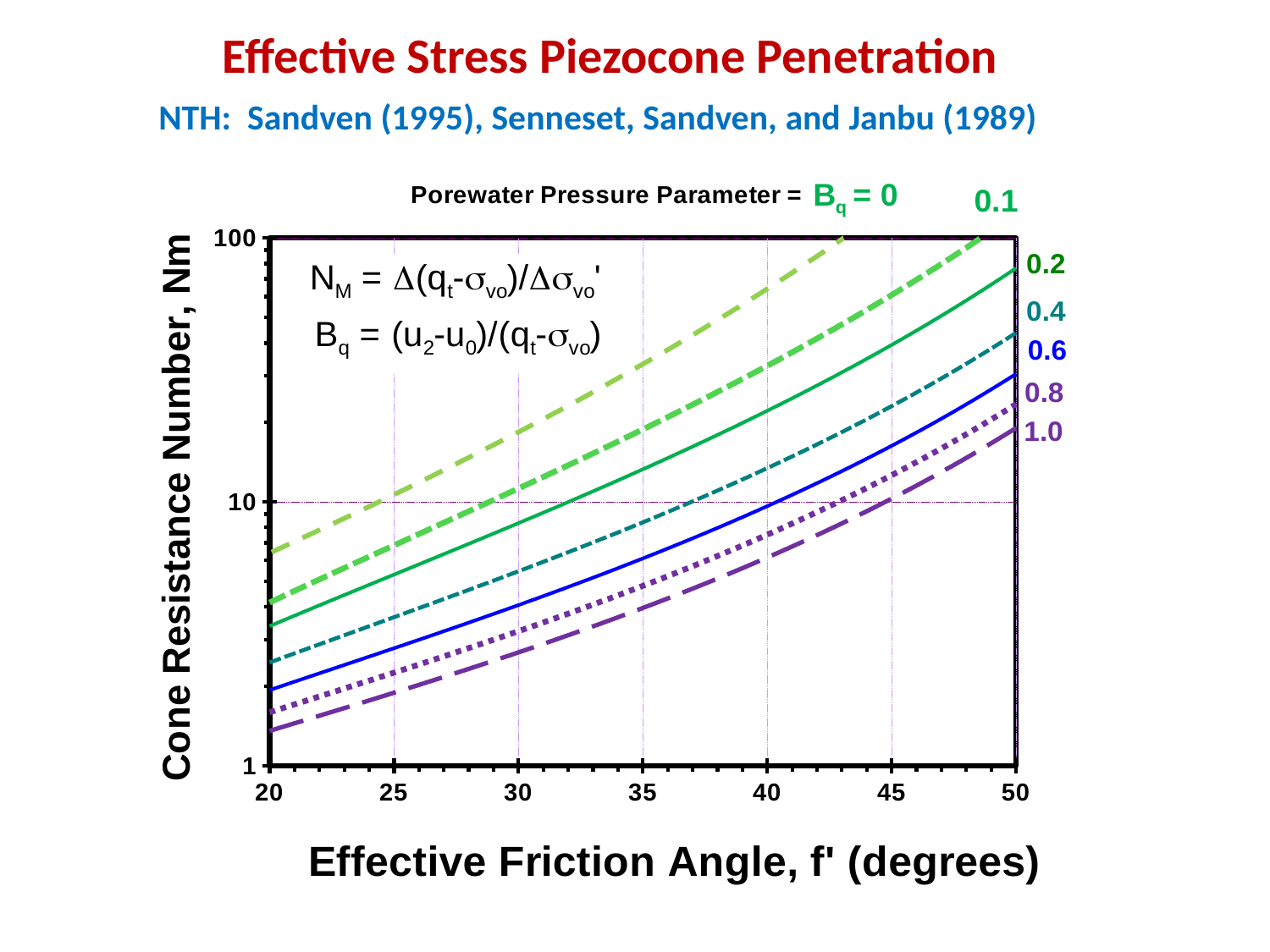
At a friction angle of 35 degrees, which curve has the larger cone resistance number, Bq = 0.2 or Bq = 0.8? Bq = 0.2 Which Bq curve has the lowest cone resistance number at any given friction angle? Bq = 1.0 What kind of chart is shown on the slide? line chart Which Bq curve has the highest cone resistance number at any given friction angle? Bq = 0 Is the cone resistance number for Bq = 1.0 at a friction angle of 40 degrees greater or less than 10? less Is the cone resistance number for Bq = 0.8 at a friction angle of 50 degrees greater or less than 10? greater What is the label of the y axis? Cone Resistance Number, Nm Is the cone resistance number for Bq = 0 at a friction angle of 30 degrees greater or less than 10? greater What is the label of the x axis? Effective Friction Angle, f' (degrees) Do the curves rise or fall as the effective friction angle increases? rise How many Bq curves are plotted on the chart? 7